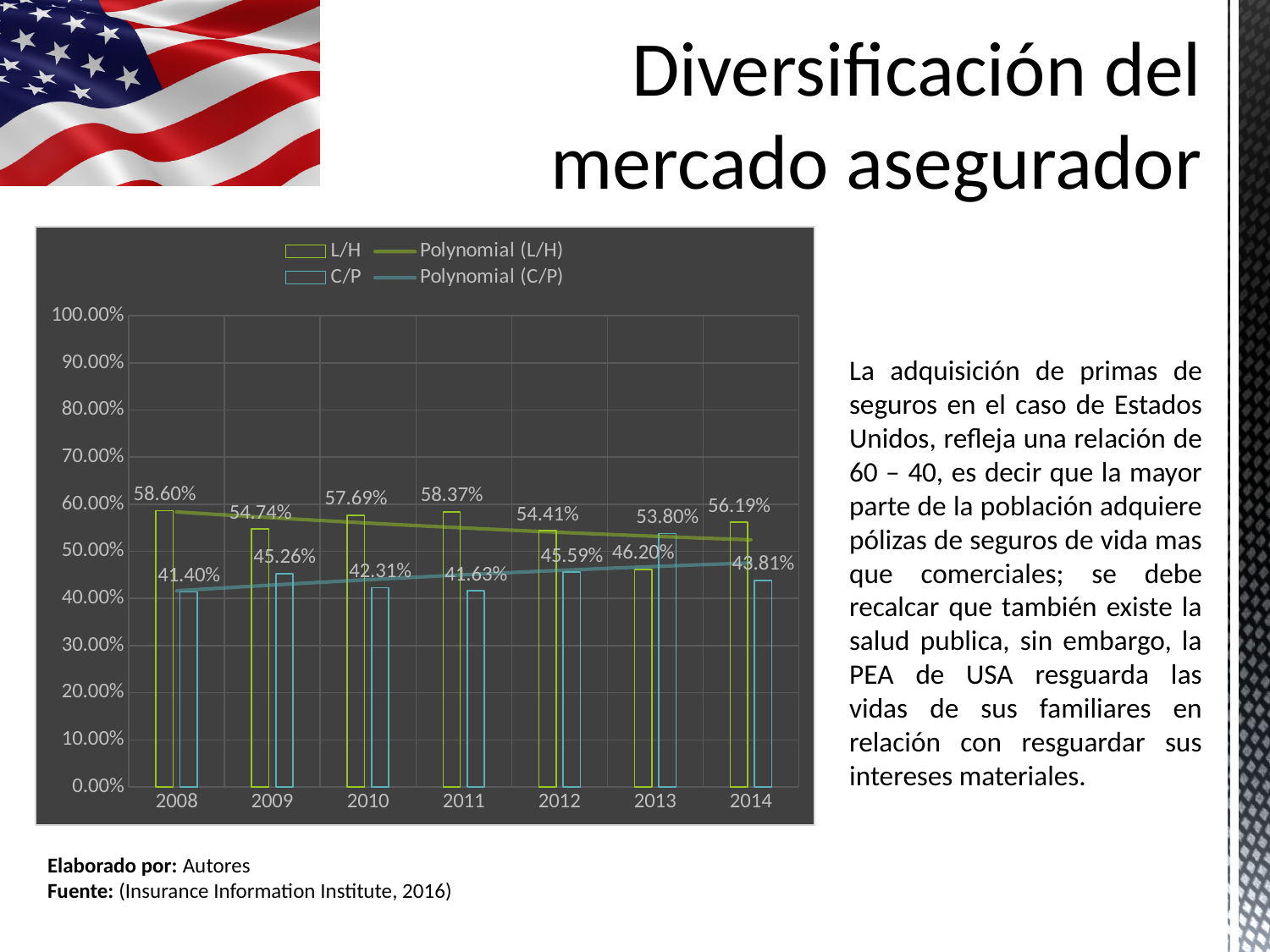
What is the L/H value for 2014? 56.19% Which year has the highest C/P value? 2013 How many years are shown on the x axis? 7 Which year has the highest L/H value? 2008 What is the L/H value for 2008? 58.60% Which is larger in 2012, the L/H value or the C/P value? L/H What kind of chart is shown on the slide? Bar chart What is the C/P value for 2013? 53.80% Which year has the lowest C/P value? 2008 How many entries does the legend list? 4 What is the C/P value for 2011? 41.63% What is the difference between the L/H and C/P values in 2010? 15.38%